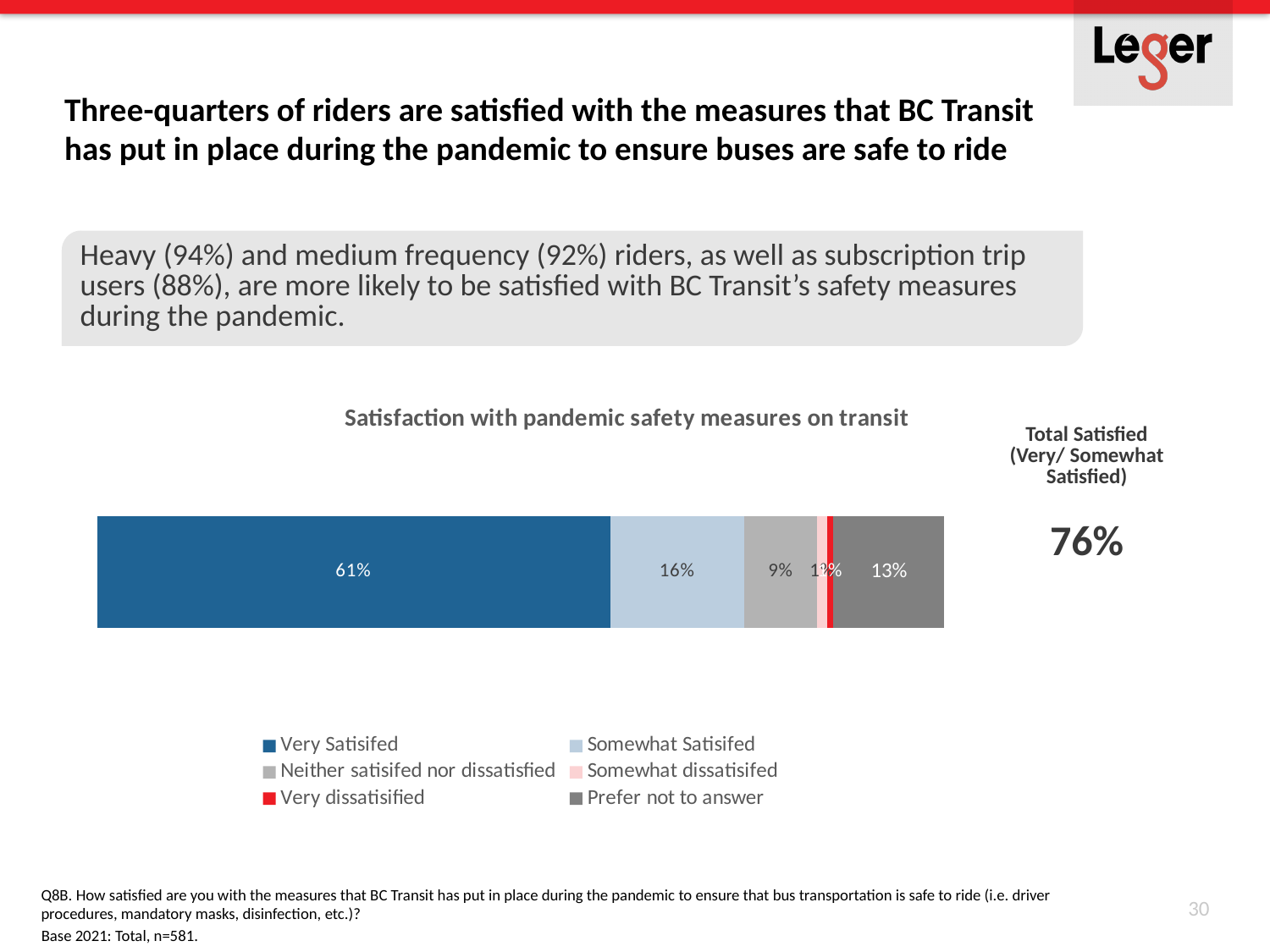
What percentage of riders are Very Satisfied with the pandemic safety measures on transit? 61% How many percentage points larger is the Very Satisfied segment than the Somewhat Satisfied segment? 45 percentage points What type of chart is used to show satisfaction with pandemic safety measures? Stacked bar chart Which response category makes up the largest segment of the satisfaction bar? Very Satisfied What percentage of riders chose Prefer not to answer in the satisfaction chart? 13% What is the title of the chart on the slide? Satisfaction with pandemic safety measures on transit How many response categories does the chart legend list? 6 What percentage of riders are Neither satisfied nor dissatisfied with the pandemic safety measures? 9% What is the Total Satisfied (Very/Somewhat Satisfied) figure shown next to the chart? 76% What percentage of riders are Somewhat Satisfied with the pandemic safety measures on transit? 16% What is the difference between the Somewhat Satisfied share and the Neither satisfied nor dissatisfied share? 7 percentage points Which is larger: the Prefer not to answer segment or the Neither satisfied nor dissatisfied segment? Prefer not to answer